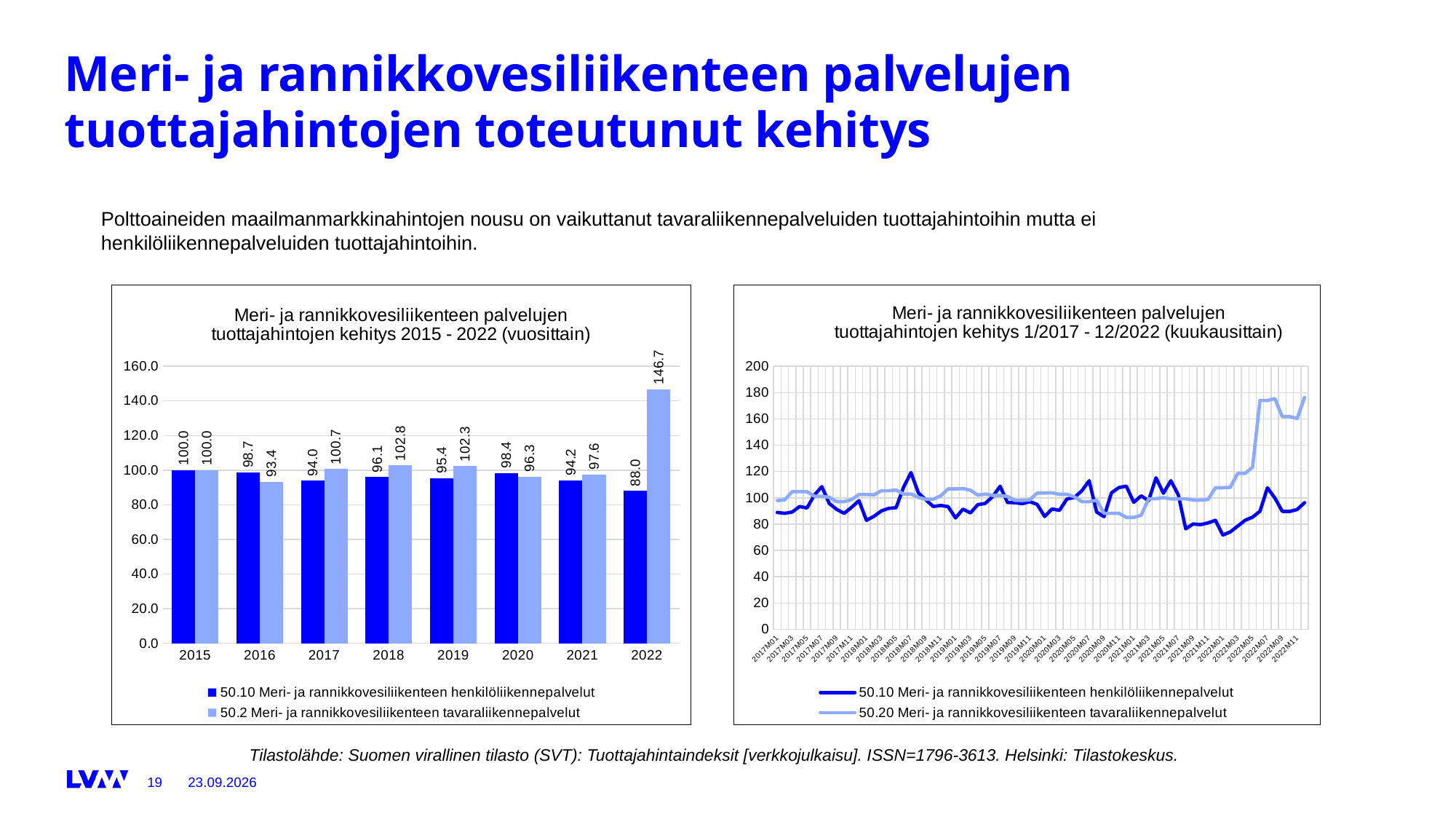
In the left chart (vuosittain), what is the difference between the tavaraliikennepalvelut and henkilöliikennepalvelut values in 2022? 58.7 In the left chart (vuosittain), how many years are shown on the x axis? 8 In the left chart (vuosittain), what is the value for 50.2 tavaraliikennepalvelut in 2018? 102.8 What kind of chart is the left chart (vuosittain)? bar chart What kind of chart is the right chart (kuukausittain)? line chart In the left chart (vuosittain), which year has the lowest value for 50.10 henkilöliikennepalvelut? 2022 In the left chart (vuosittain), which series has the larger value in 2016, henkilöliikennepalvelut or tavaraliikennepalvelut? henkilöliikennepalvelut In the right chart (kuukausittain), how many series does the legend list? 2 In the right chart (kuukausittain), is the value for 50.20 tavaraliikennepalvelut at 2022M07 greater or less than 160? greater In the left chart (vuosittain), what is the value for 50.10 Meri- ja rannikkovesiliikenteen henkilöliikennepalvelut in 2022? 88.0 In the left chart (vuosittain), which year has the highest value for 50.2 tavaraliikennepalvelut? 2022 In the left chart (vuosittain), what is the value for 50.2 Meri- ja rannikkovesiliikenteen tavaraliikennepalvelut in 2022? 146.7